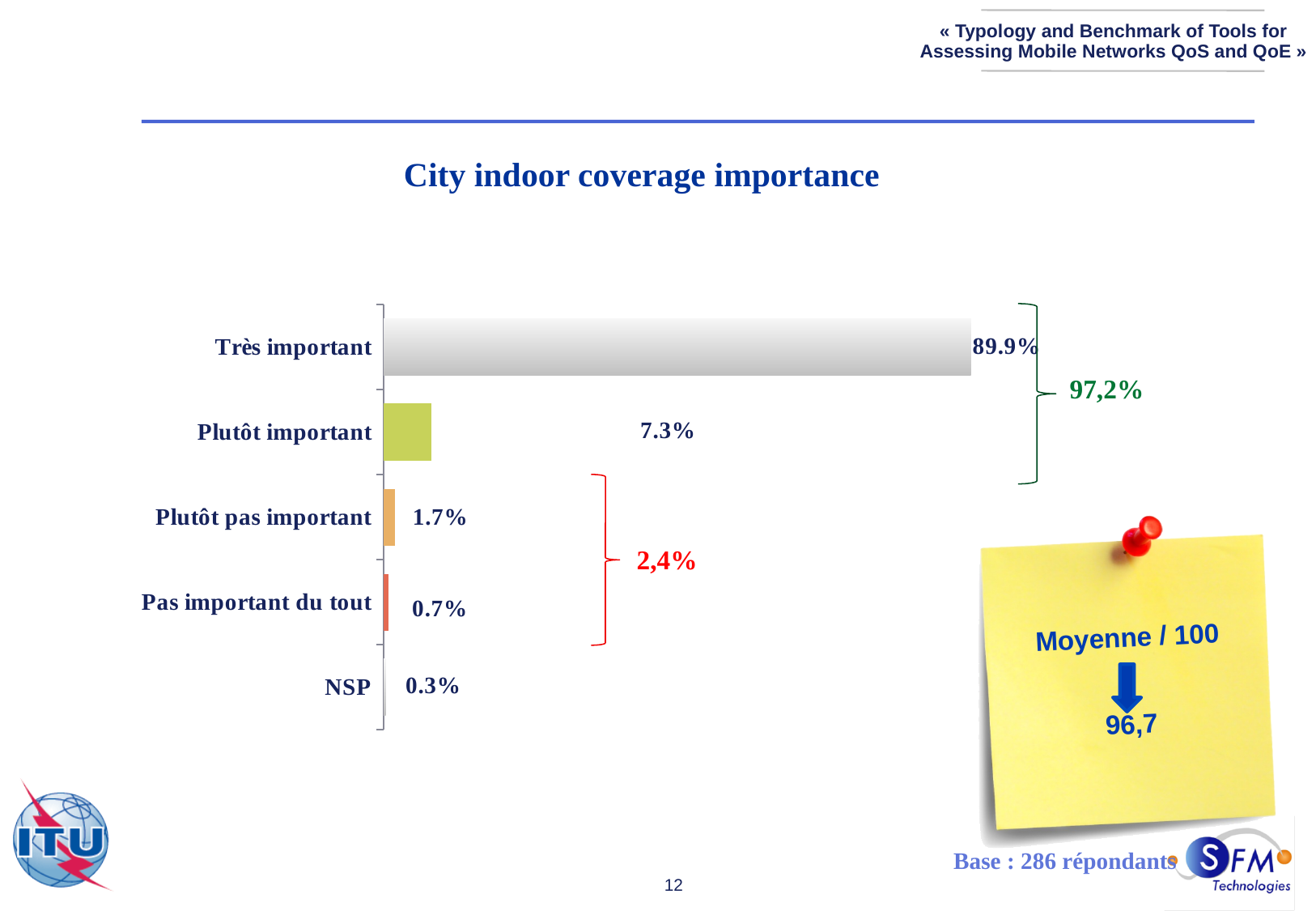
Which category has the lowest value? NSP Which category has the highest value? Très important What is the value for "Très important"? 89.9% What is the value for "NSP"? 0.3% What kind of chart is shown on the slide? Bar chart What is the value for "Pas important du tout"? 0.7% What is the value for "Plutôt pas important"? 1.7% What is the difference between the values for "Très important" and "Plutôt important"? 82.6% Which is larger, the value for "Plutôt pas important" or the value for "Pas important du tout"? Plutôt pas important What is the value for "Plutôt important"? 7.3% How many categories are shown in the chart? 5 What is the title of the chart? City indoor coverage importance